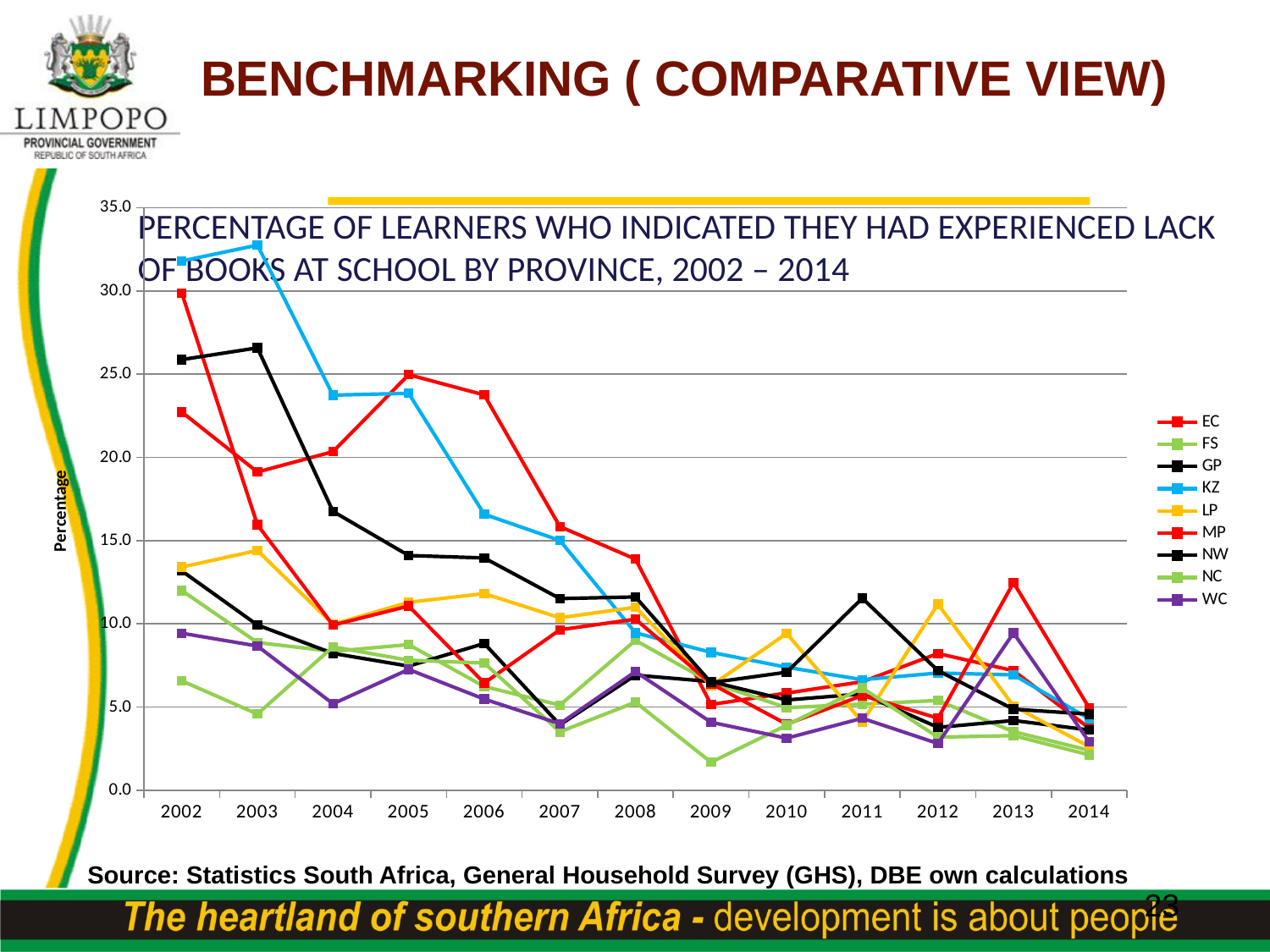
How many series does the legend list? 9 What kind of chart is shown on the slide? line chart Is the value for LP in 2012 greater or less than 10? greater Does the KZ line generally rise or fall from 2002 to 2014? fall Which province's line reaches the highest point on the chart? KZ Which is larger in 2002, the value for KZ or the value for WC? KZ How many years are shown along the x axis? 13 Is the value for KZ in 2003 greater or less than 30? greater In which year does the KZ line reach its highest value? 2003 What is the label on the vertical axis? Percentage Is the value for WC in 2013 greater or less than 10? less In which year does the KZ line reach its lowest value? 2014